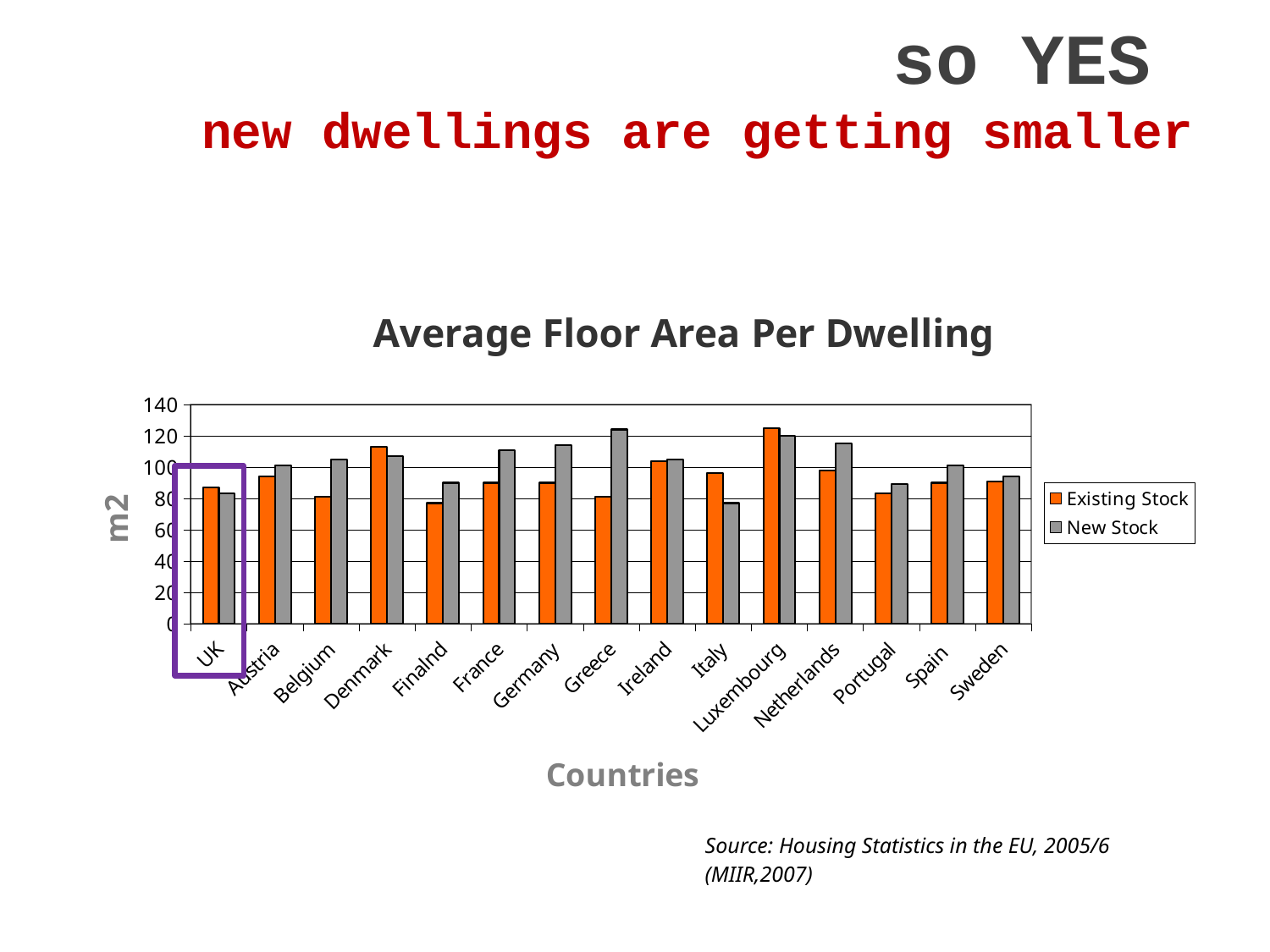
How many countries are shown on the x axis? 15 How many series does the legend list? 2 Which country is highlighted with a purple box on the chart? UK Is the New Stock value for Italy greater or less than 80? less Is the Existing Stock value for Luxembourg greater or less than 120? greater Which country has the lowest New Stock value? Italy What type of chart is shown on the slide? bar chart For Greece, which is larger: Existing Stock or New Stock? New Stock For Italy, which is larger: Existing Stock or New Stock? Existing Stock Is the New Stock value for Greece greater or less than 120? greater Which country has the highest Existing Stock value? Luxembourg What is the title of the chart? Average Floor Area Per Dwelling